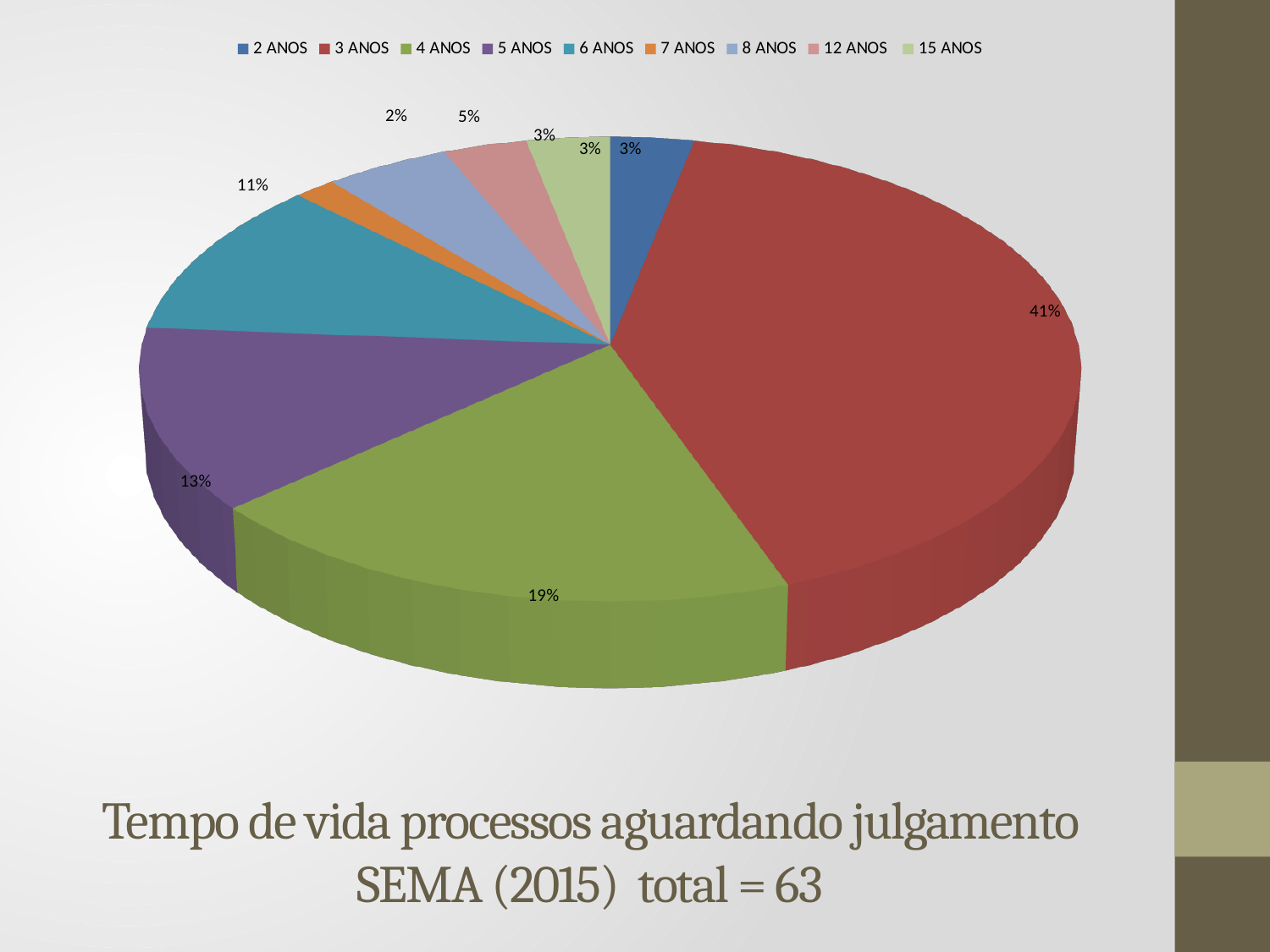
Which category has the smallest slice of the pie? 7 ANOS What total is stated in the chart title? 63 How many categories does the legend list? 9 What kind of chart is shown on the slide? pie chart What is the value shown for 6 ANOS? 11% Which category has the largest slice of the pie? 3 ANOS What is the difference between the values for 3 ANOS and 4 ANOS? 22% Which is larger, the value for 5 ANOS or the value for 6 ANOS? 5 ANOS What is the value shown for 8 ANOS? 5% What share of the pie does the 3 ANOS slice represent? 41% What is the value shown for 4 ANOS? 19% What is the value shown for 5 ANOS? 13%